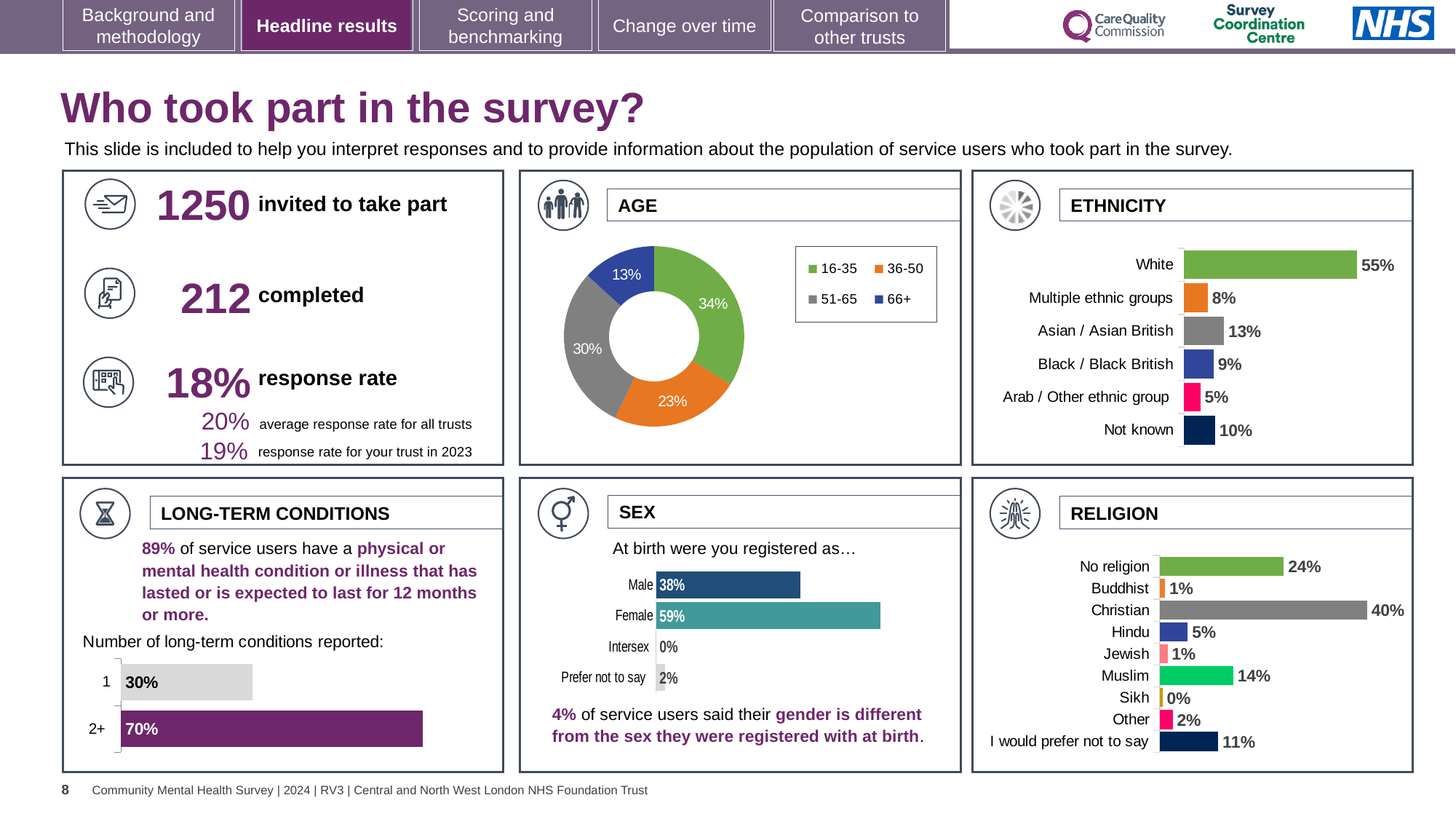
In the RELIGION chart, what is the value for Muslim? 14% In the SEX chart, what is the value for Prefer not to say? 2% How many series does the legend of the AGE chart list? 4 In the RELIGION chart, which category has the highest value? Christian In the ETHNICITY chart, which category has the highest value? White In the ETHNICITY chart, what is the difference between White and Not known? 45% In the AGE chart, what percentage of respondents were aged 16-35? 34% What kind of chart is the AGE chart? Doughnut chart How many categories are shown in the RELIGION chart? 9 In the LONG-TERM CONDITIONS chart, what is the value for 2+ conditions? 70% In the ETHNICITY chart, what is the value for Asian / Asian British? 13% In the SEX chart, which is larger, Male or Female? Female